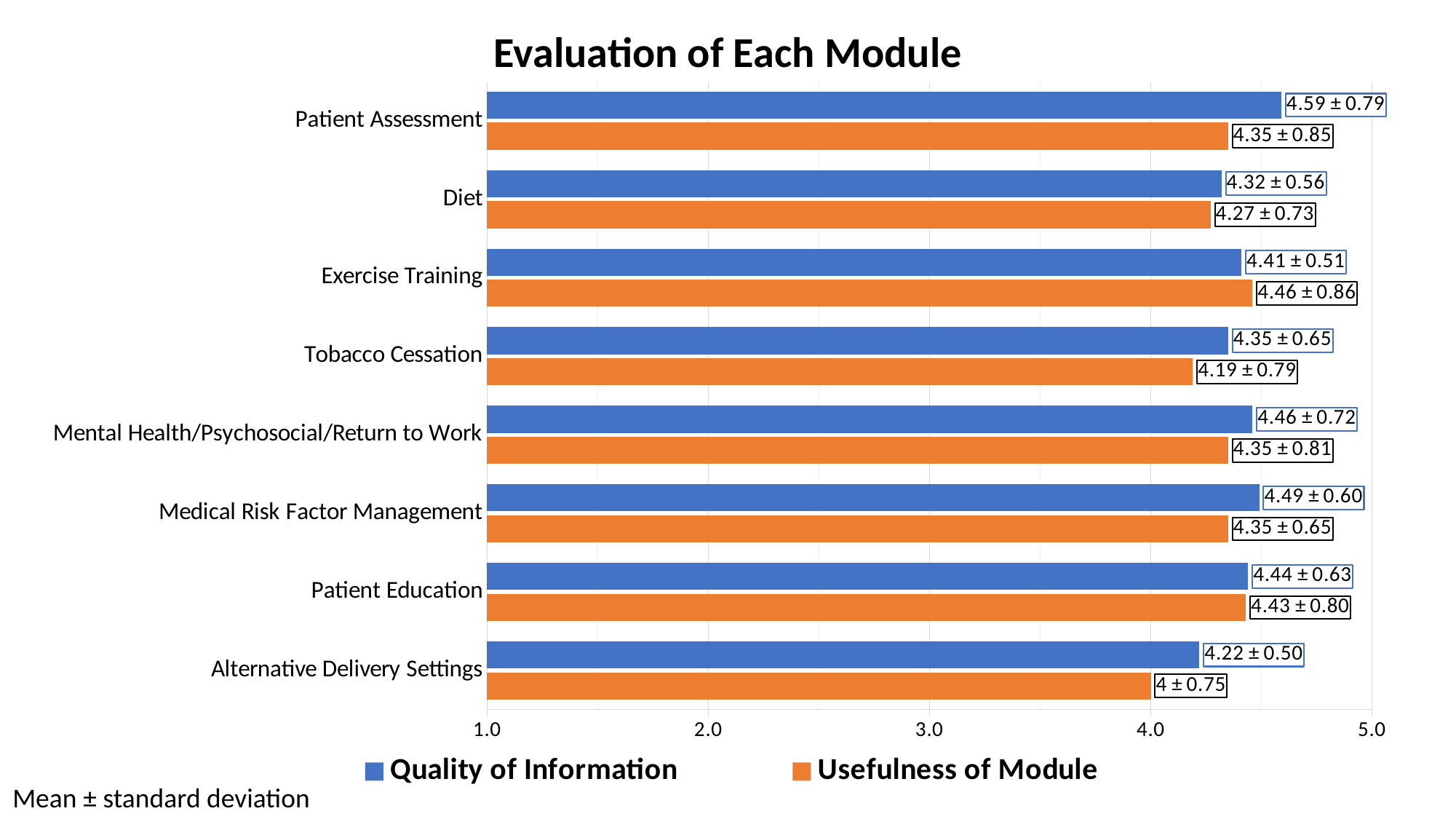
How many series does the legend list? 2 Which module has the lowest Quality of Information mean? Alternative Delivery Settings Which module has the lowest Usefulness of Module mean? Alternative Delivery Settings What is the difference between the Quality of Information mean and the Usefulness of Module mean for Patient Assessment? 0.24 What type of chart is shown? Bar chart What is the Usefulness of Module value for Alternative Delivery Settings? 4 ± 0.75 What is the Quality of Information value for Patient Assessment? 4.59 ± 0.79 How many modules are shown on the chart? 8 What is the Quality of Information value for Medical Risk Factor Management? 4.49 ± 0.60 Which module has the highest Quality of Information mean? Patient Assessment For Tobacco Cessation, which is larger: the Quality of Information mean or the Usefulness of Module mean? Quality of Information What is the Usefulness of Module value for Exercise Training? 4.46 ± 0.86